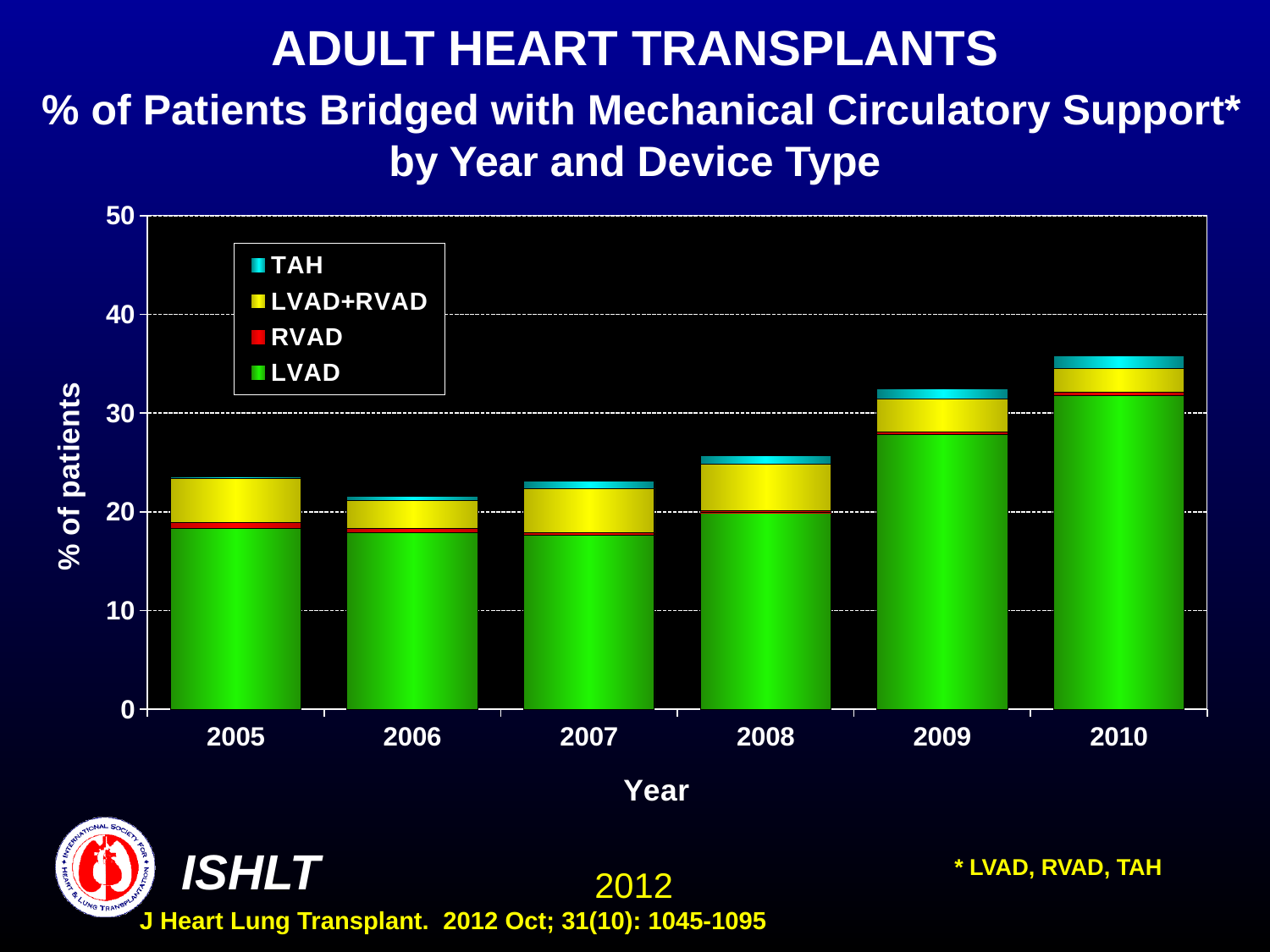
Is the total bar for 2006 greater or less than 30? less Is the LVAD segment for 2005 greater or less than 20? less What colour represents LVAD in the chart legend? Green Is the total bar for 2008 greater or less than 30? less How many years are shown on the x axis of the chart? 6 What kind of chart is shown on the slide? Stacked bar chart From 2006 to 2010, do the total bars rise or fall? rise How many device types does the legend list? 4 Which year has the larger total bar, 2005 or 2010? 2010 Which year has the highest total percentage of patients bridged with mechanical circulatory support? 2010